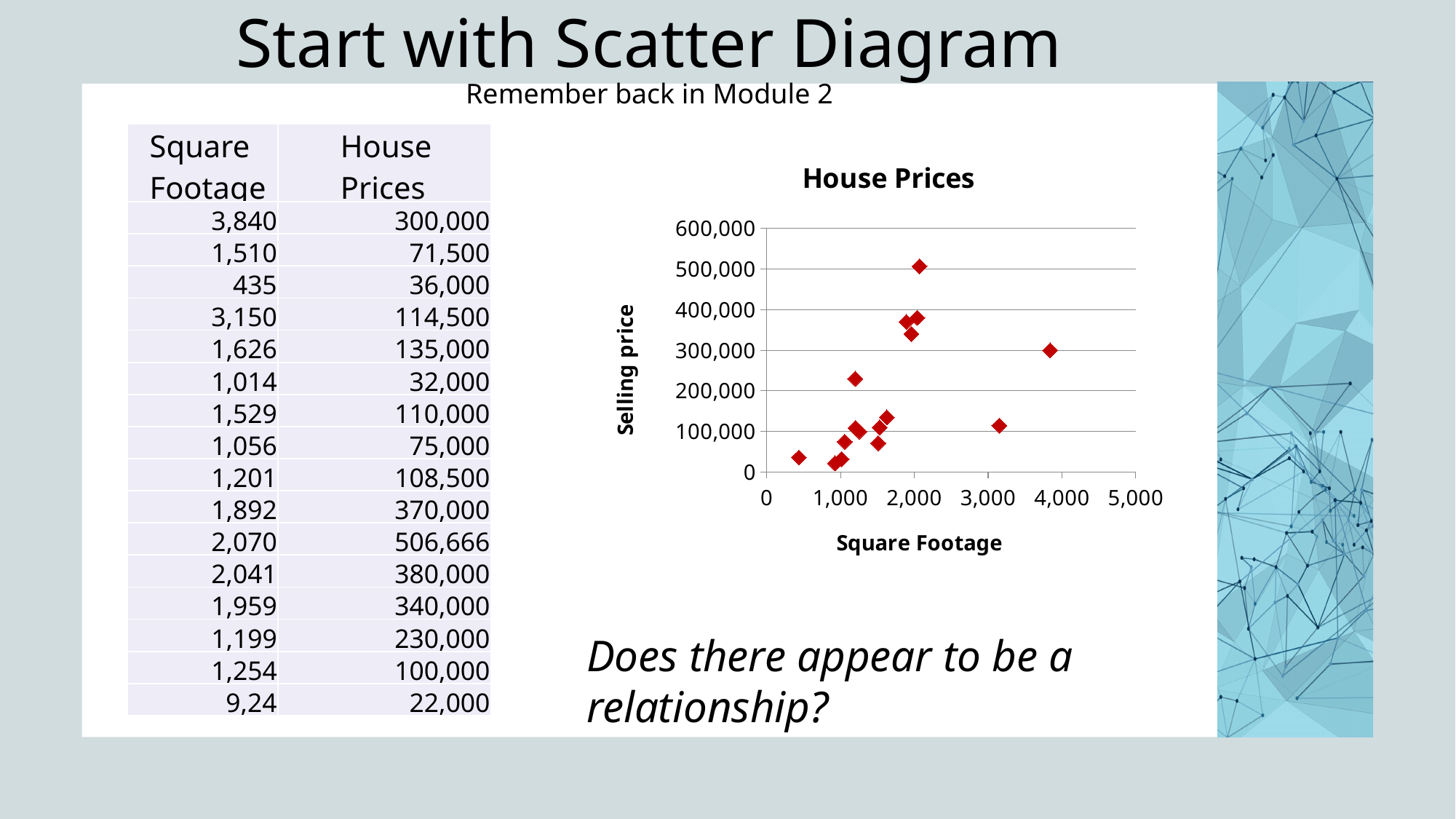
Is the selling price of the point at roughly 3,800 square feet greater or less than 200,000? greater Which has the higher selling price: the point near 3,800 square feet or the point near 3,150 square feet? The point near 3,800 square feet According to the table, what is the house price for the 3,840 square foot house? 300,000 What is the title of the chart? House Prices What is the title of the vertical axis of the chart? Selling price Is the selling price of the point at roughly 3,150 square feet greater or less than 200,000? less Is the selling price of the highest point on the chart greater or less than 500,000? greater What kind of chart is shown on the slide? Scatter chart According to the table, what is the highest house price listed? 506,666 Do selling prices generally rise or fall as square footage increases on the chart? Rise What is the highest tick value shown on the vertical axis of the chart? 600,000 What is the highest tick value shown on the horizontal axis of the chart? 5,000